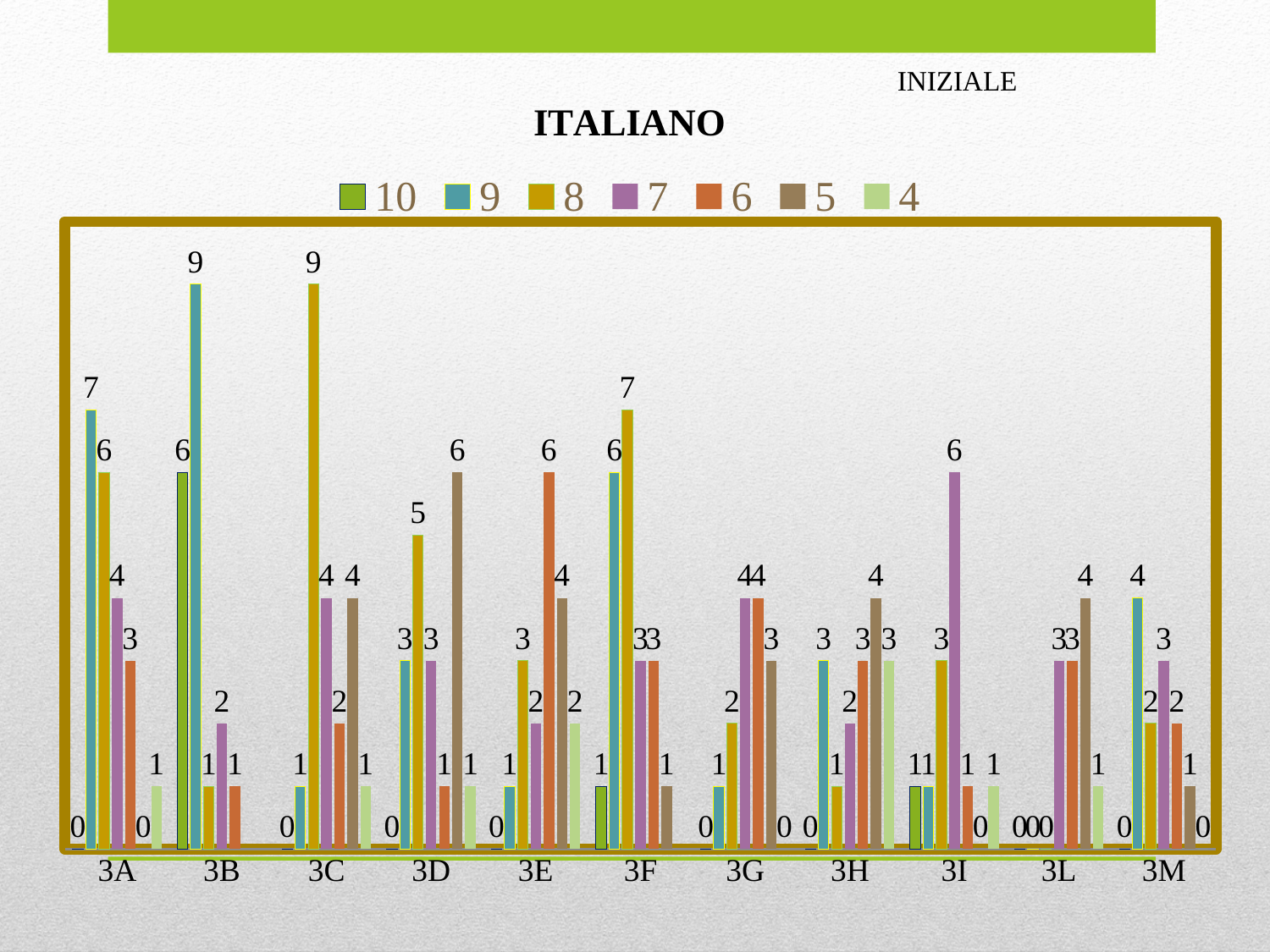
How many series does the legend list? 7 What is the value of series 8 for category 3C? 9 What kind of chart is shown on the slide? bar chart What is the value of series 9 for category 3A? 7 Which category has the larger value for series 9, 3B or 3F? 3B What is the title of the chart? ITALIANO What is the difference between series 9 and series 8 for category 3A? 1 How many categories are shown on the x axis? 11 What is the value of series 5 for category 3D? 6 Which category has the highest value for series 8? 3C What is the value of series 7 for category 3I? 6 What is the value of series 6 for category 3E? 6